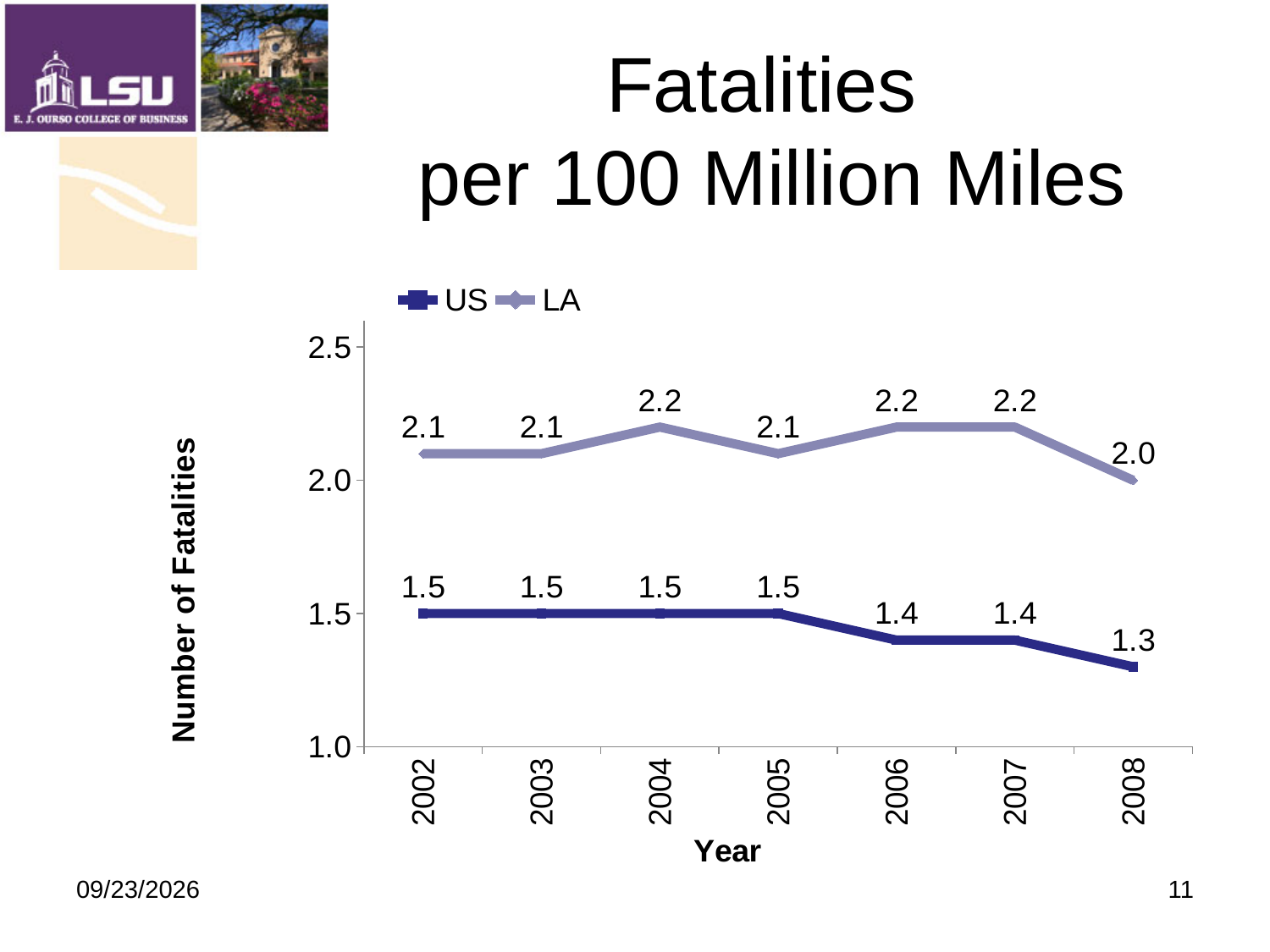
What is the value for US in 2008? 1.3 What is the difference between the LA and US values in 2007? 0.8 Is the value for LA in 2006 greater or less than 2.0? greater How many years are shown on the x axis? 7 How many series does the legend list? 2 Does the US series rise or fall from 2005 to 2008? fall Which is larger in 2005, the US value or the LA value? LA What is the value for US in 2006? 1.4 What kind of chart is shown on the slide? line chart What is the value for LA in 2008? 2.0 What is the value for LA in 2004? 2.2 In which year is the US value lowest? 2008